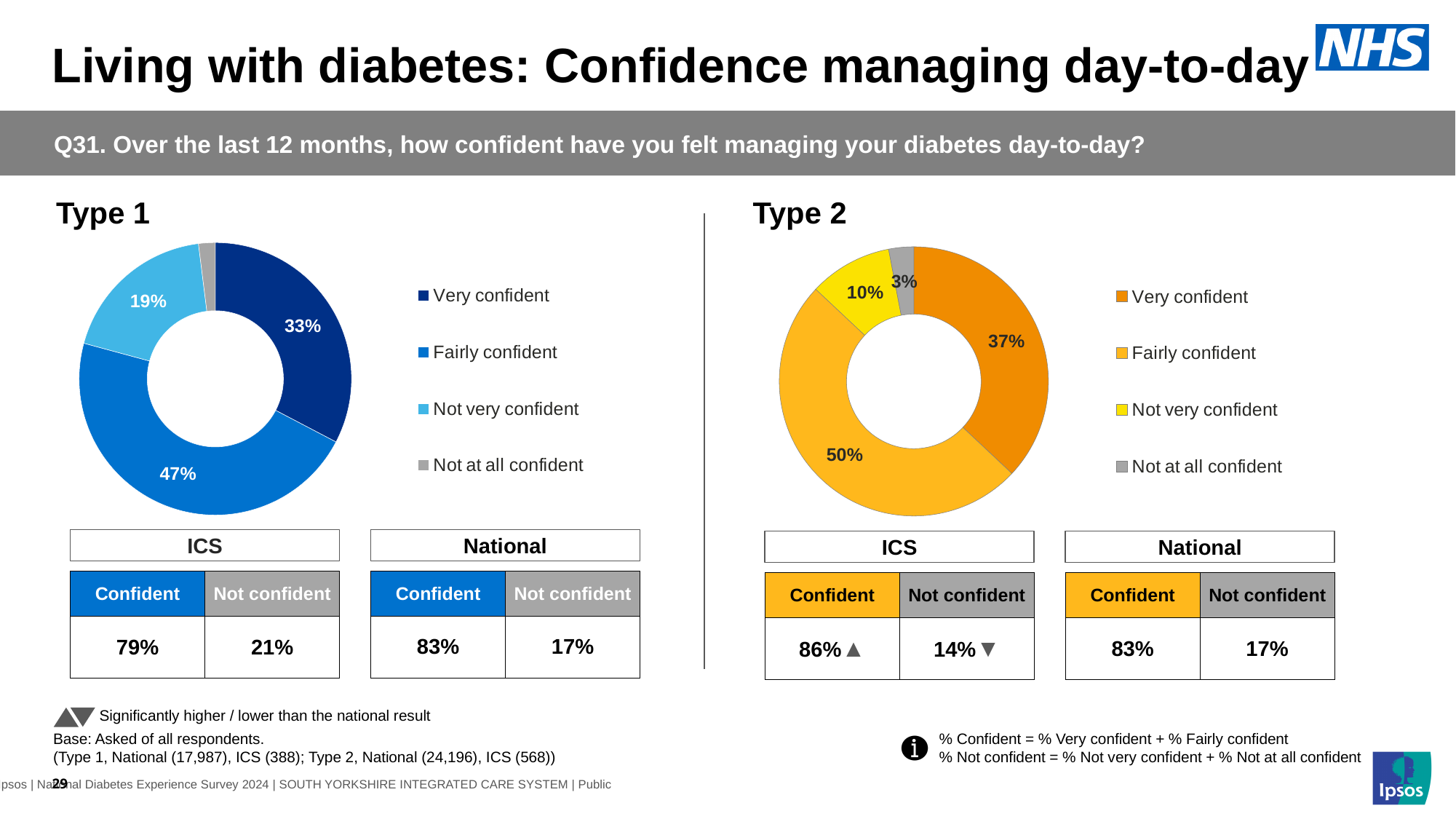
In the Type 2 chart, what percentage of respondents were fairly confident? 50% What kind of chart is used for Type 1? Doughnut (pie) chart In the Type 1 chart, what percentage of respondents were not very confident? 19% In the Type 2 chart, which category has the smallest share? Not at all confident In the Type 1 chart, which is larger: the Very confident share or the Not very confident share? Very confident In the Type 1 chart, what percentage of respondents were very confident? 33% In the Type 1 chart, what percentage of respondents were fairly confident? 47% In the Type 2 chart, what percentage of respondents were not at all confident? 3% How many categories does the legend of the Type 2 chart list? 4 In the Type 1 chart, which category has the largest share? Fairly confident In the Type 2 chart, which category has the largest share? Fairly confident In the Type 2 chart, what is the difference between the Fairly confident and Very confident shares? 13 percentage points